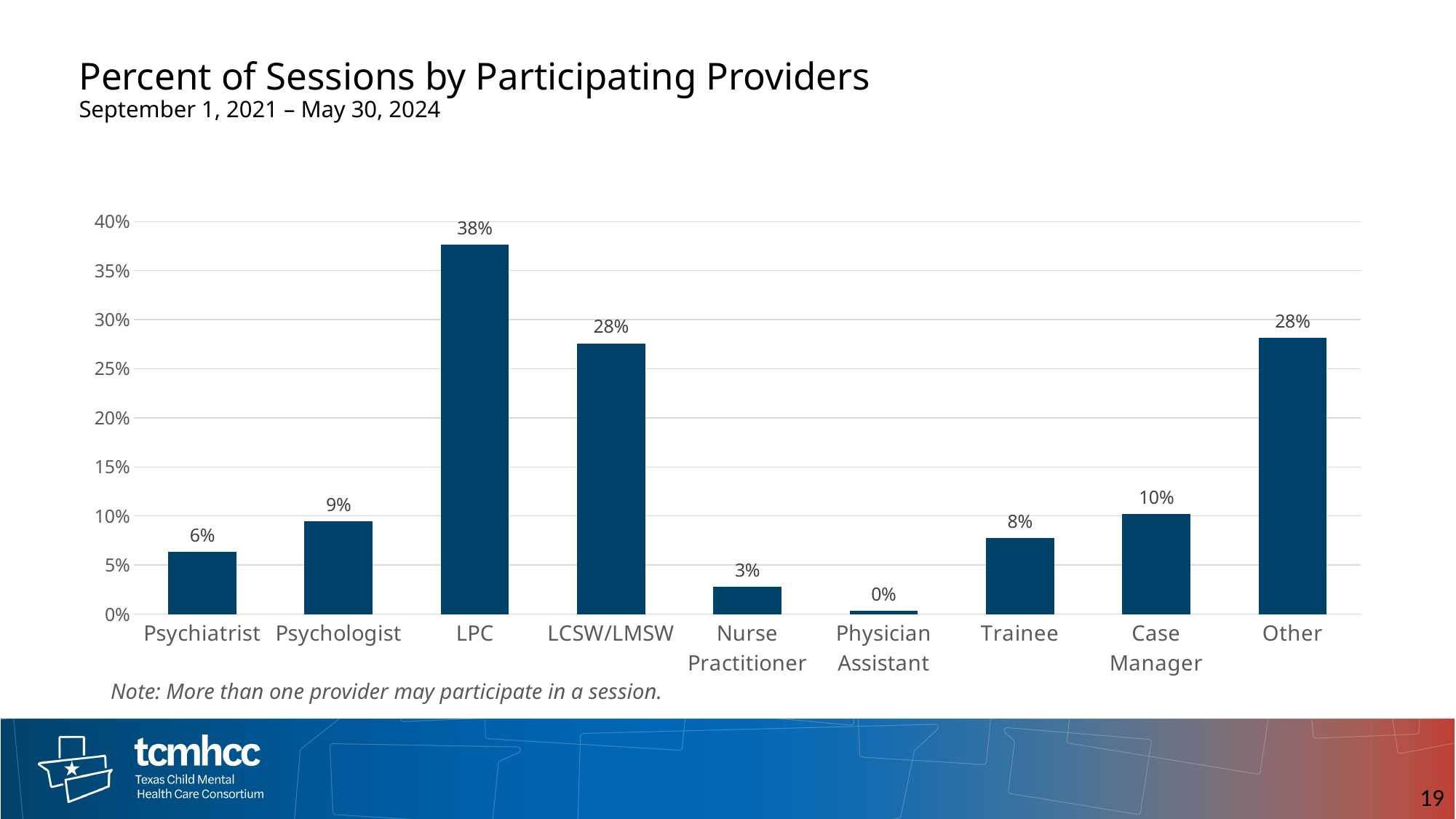
Which provider type has the highest percent of sessions? LPC What is the difference between the LPC value and the LCSW/LMSW value? 10% Which is larger, the value for Psychologist or the value for Trainee? Psychologist How many provider categories are shown on the x axis? 9 What percent of sessions had a Nurse Practitioner participating? 3% What percent of sessions had an LPC participating? 38% Is the value for Other greater or less than 25%? greater What is the value shown for Case Manager? 10% What date range does the chart subtitle give? September 1, 2021 – May 30, 2024 What kind of chart is shown on the slide? Bar chart Which provider type has the lowest percent of sessions? Physician Assistant What is the title of the chart? Percent of Sessions by Participating Providers